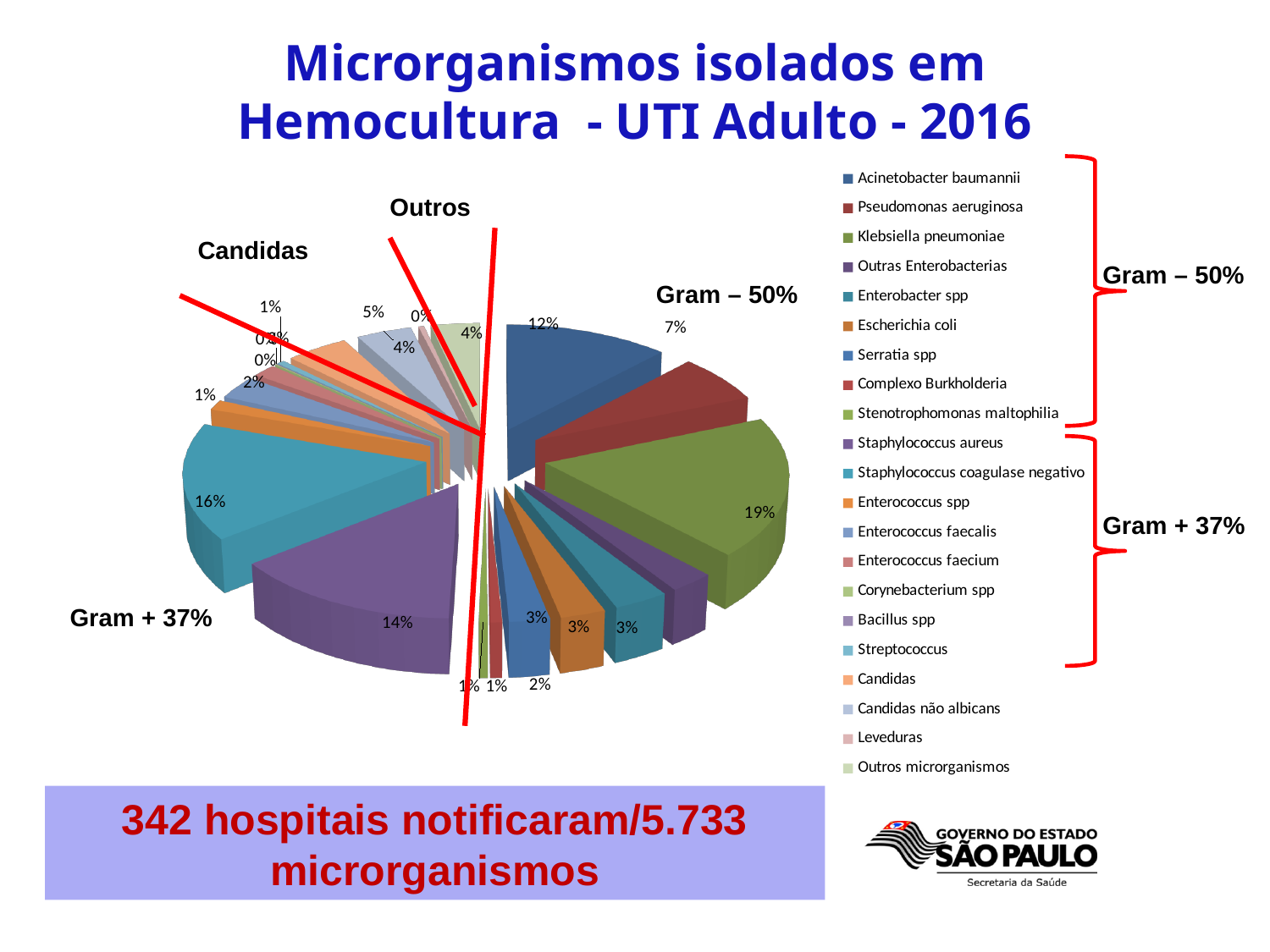
According to the annotation on the slide, what percentage of the isolates are Gram-negative (Gram –)? 50% What kind of chart is shown on the slide? pie chart What share of the pie does Pseudomonas aeruginosa represent? 7% What share of the pie does Klebsiella pneumoniae represent? 19% What share of the pie does Staphylococcus coagulase negativo represent? 16% Which microorganism has the largest share of the pie? Klebsiella pneumoniae What is the difference between the shares of Klebsiella pneumoniae and Acinetobacter baumannii? 7% What is the title of the chart? Microrganismos isolados em Hemocultura - UTI Adulto - 2016 How many entries does the legend list? 21 Which is larger, the share for Staphylococcus coagulase negativo or for Staphylococcus aureus? Staphylococcus coagulase negativo